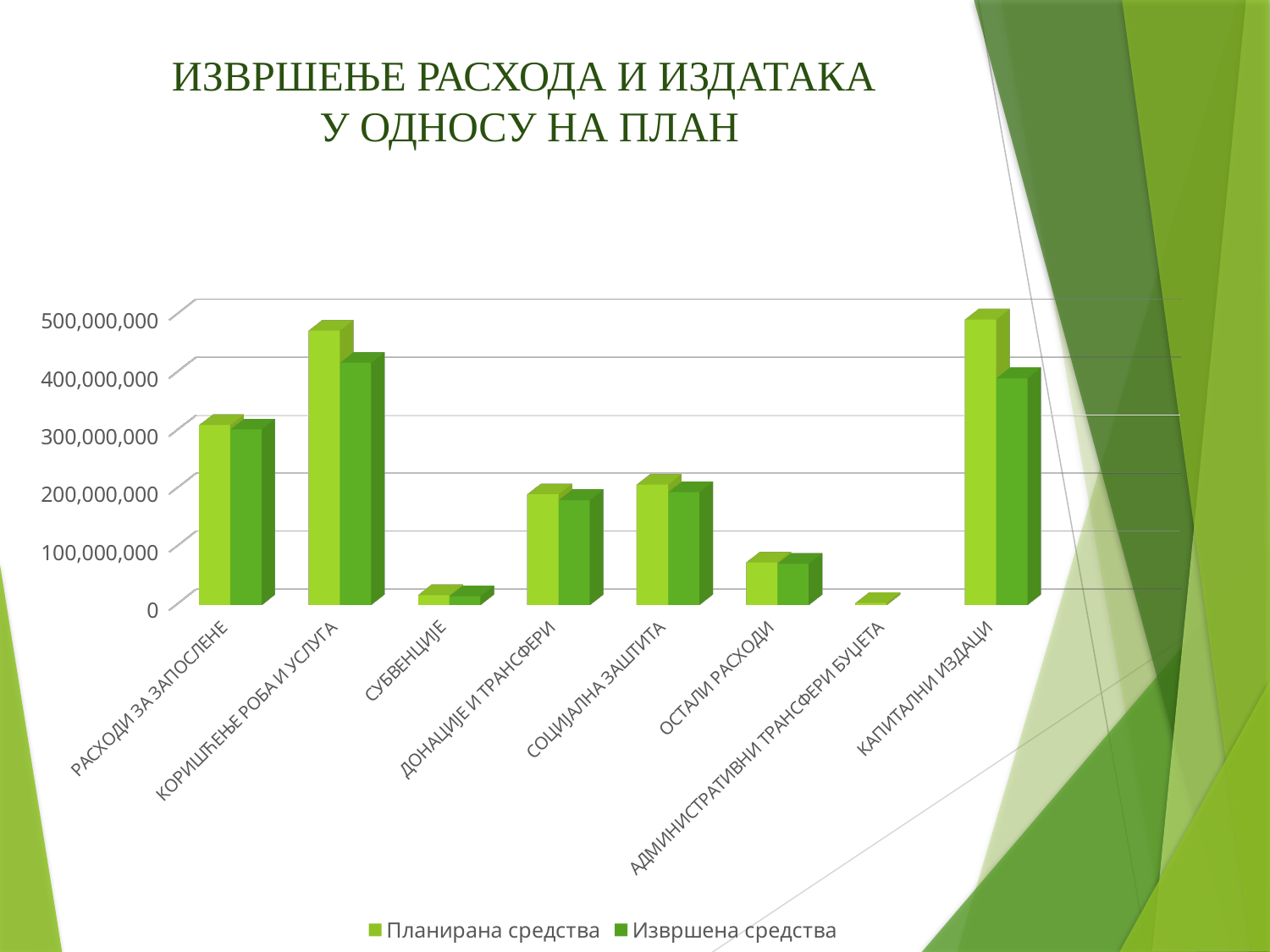
Which category has the highest value for Извршена средства? КОРИШЋЕЊЕ РОБА И УСЛУГА Is the Планирана средства value for СУБВЕНЦИЈЕ greater or less than 100,000,000? less Which is larger: the Извршена средства value for КОРИШЋЕЊЕ РОБА И УСЛУГА or for КАПИТАЛНИ ИЗДАЦИ? КОРИШЋЕЊЕ РОБА И УСЛУГА Is the Планирана средства value for ОСТАЛИ РАСХОДИ greater or less than 100,000,000? less What kind of chart is shown on the slide? bar chart Which category has the lowest value for Извршена средства? СУБВЕНЦИЈЕ What are the two series named in the chart legend? Планирана средства and Извршена средства How many series does the chart legend list? 2 How many categories are shown on the x axis of the chart? 8 Is the Планирана средства value for КОРИШЋЕЊЕ РОБА И УСЛУГА greater or less than 400,000,000? greater For КАПИТАЛНИ ИЗДАЦИ, which is larger: Планирана средства or Извршена средства? Планирана средства